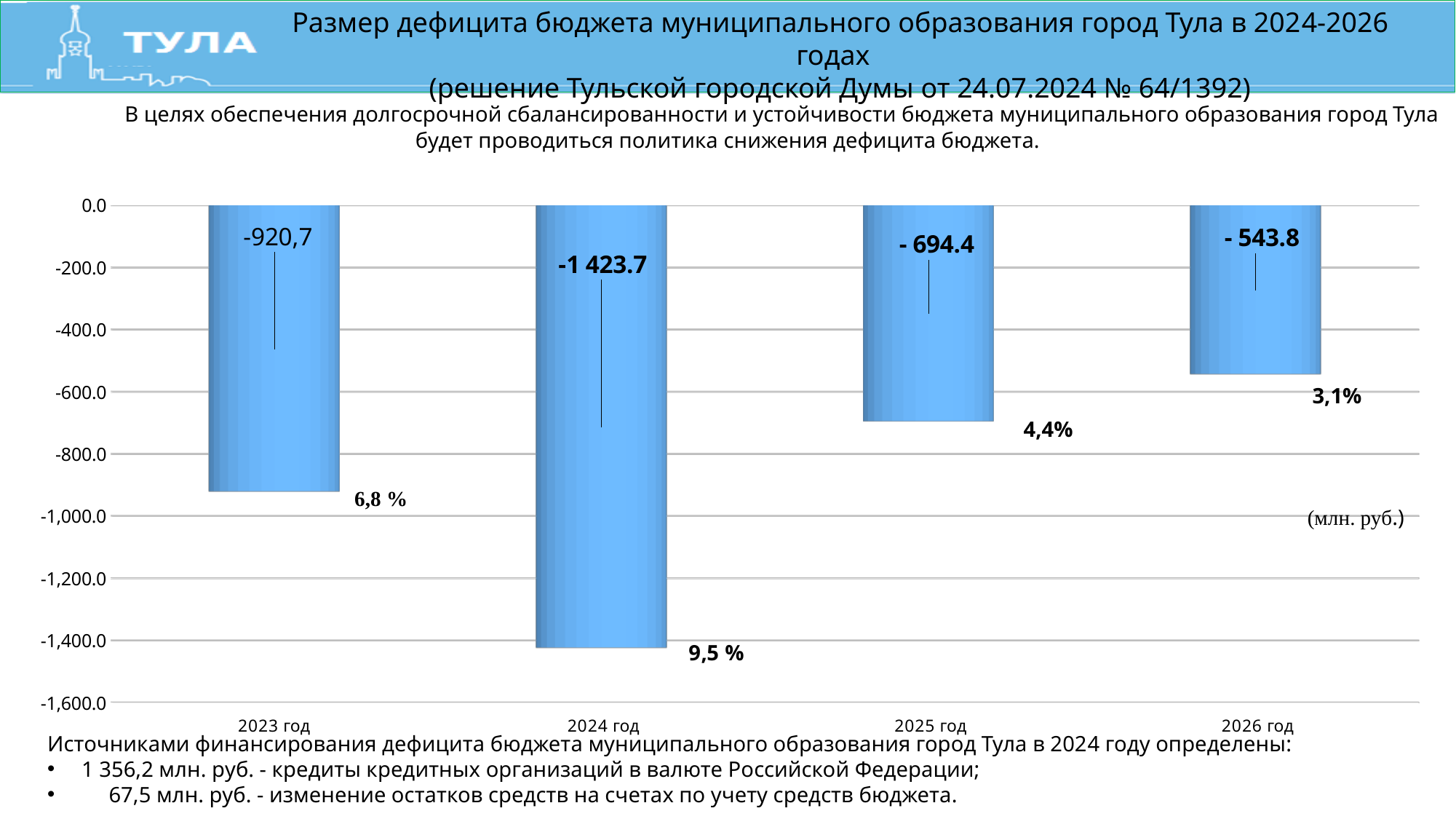
What is the data label on the bar for 2025 год? - 694.4 What is the data label on the bar for 2026 год? - 543.8 How many years (bars) are shown in the chart? 4 Which year has the smallest budget deficit (the shortest bar)? 2026 год Which year has a larger deficit in absolute value, 2023 год or 2025 год? 2023 год What percentage is printed next to the bar for 2024 год? 9,5 % Which year has the largest budget deficit (the longest bar)? 2024 год What percentage is printed next to the bar for 2026 год? 3,1% What unit of measurement is indicated on the chart? млн. руб. What is the data label on the bar for 2024 год? -1 423.7 What is the data label on the bar for 2023 год? -920,7 By how much does the deficit for 2025 год exceed the deficit for 2026 год, in absolute value? 150.6